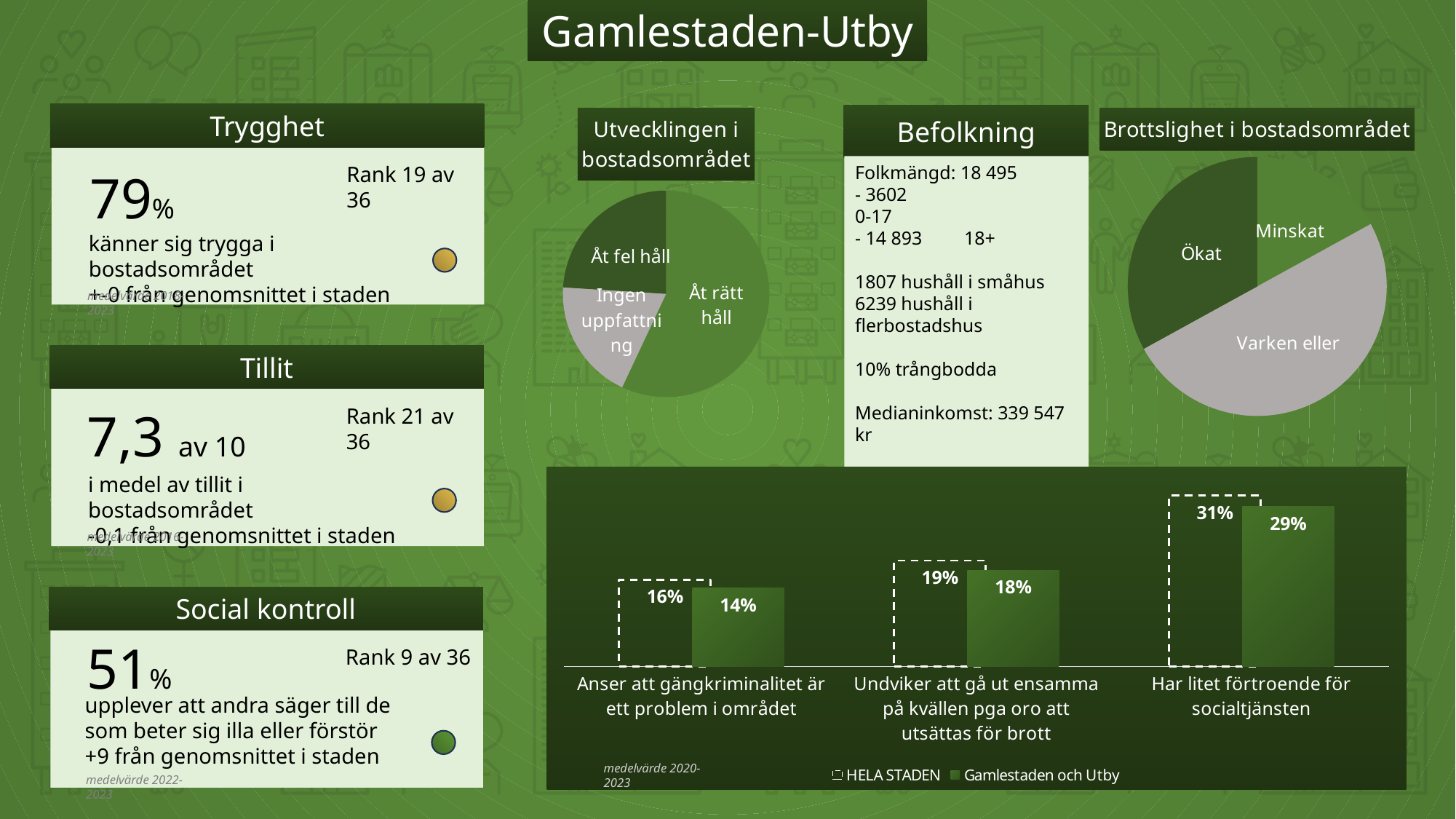
In the bar chart at the bottom of the slide, which is larger for 'Anser att gängkriminalitet är ett problem i området': HELA STADEN or Gamlestaden och Utby? HELA STADEN In the pie chart 'Brottslighet i bostadsområdet', which slice is the largest? Varken eller In the pie chart 'Utvecklingen i bostadsområdet', which slice is the largest? Åt rätt håll How many series does the legend of the bar chart at the bottom of the slide list? 2 In the bar chart at the bottom of the slide, which category has the highest value for Gamlestaden och Utby? Har litet förtroende för socialtjänsten In the bar chart at the bottom of the slide, which category has the lowest value for HELA STADEN? Anser att gängkriminalitet är ett problem i området In the bar chart at the bottom of the slide, what is the value for HELA STADEN for 'Anser att gängkriminalitet är ett problem i området'? 16% In the bar chart at the bottom of the slide, what is the value for Gamlestaden och Utby for 'Har litet förtroende för socialtjänsten'? 29% In the bar chart at the bottom of the slide, what is the difference between HELA STADEN and Gamlestaden och Utby for 'Har litet förtroende för socialtjänsten'? 2% How many categories are shown in the bar chart at the bottom of the slide? 3 In the bar chart at the bottom of the slide, what is the value for Gamlestaden och Utby for 'Undviker att gå ut ensamma på kvällen pga oro att utsättas för brott'? 18% What kind of chart is 'Utvecklingen i bostadsområdet'? Pie chart